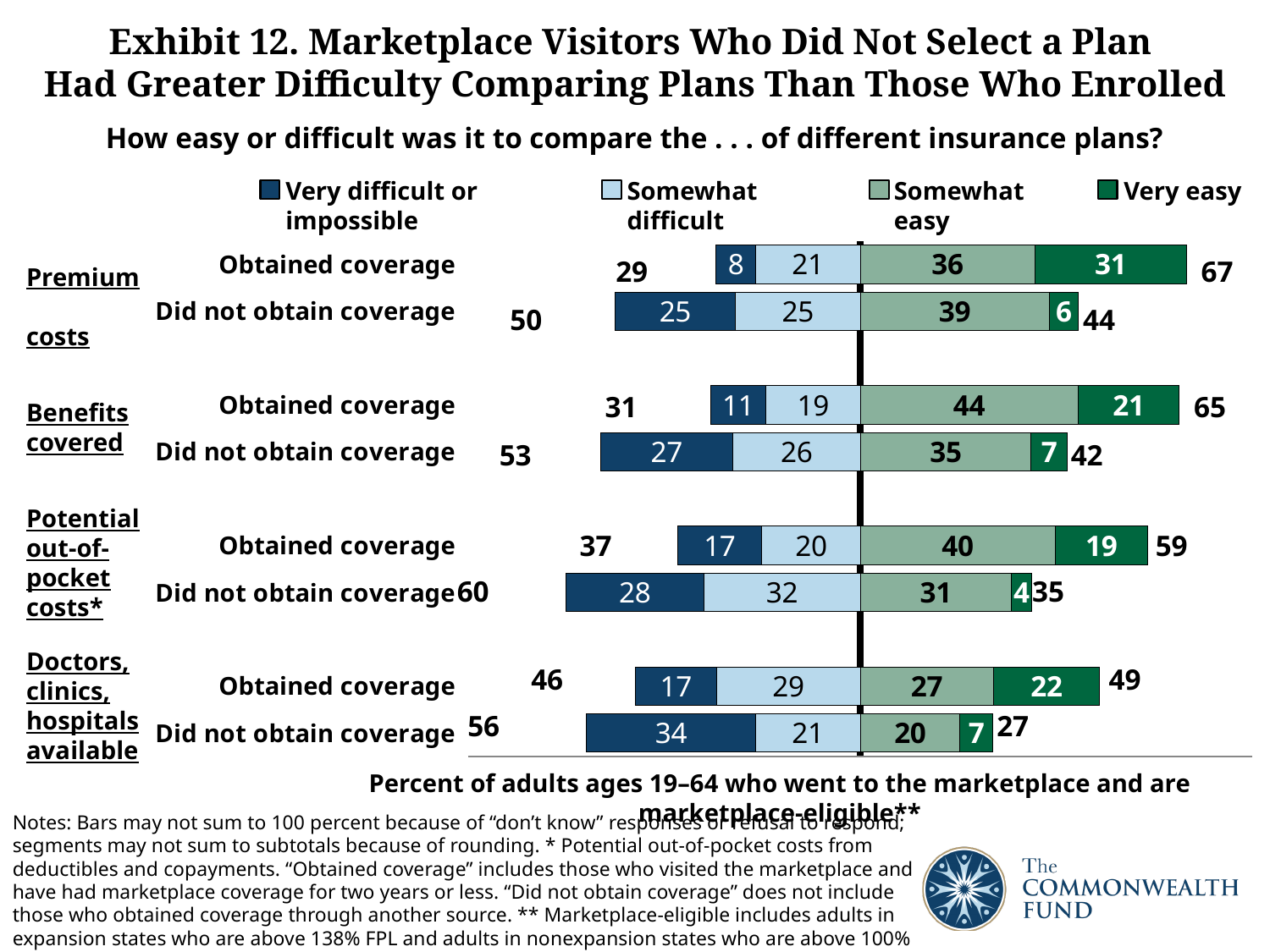
For benefits covered, what is the difference in the 'Somewhat easy' value between those who obtained coverage and those who did not? 9 How many plan features (row groups) are compared in the chart? 4 What percentage of those who obtained coverage said comparing premium costs was very easy? 31 How many response categories does the legend list? 4 Which bar has the lowest 'Very easy' value? Potential out-of-pocket costs, Did not obtain coverage Which response category is shown in the darkest blue in the legend? Very difficult or impossible Which bar has the highest 'Very easy' value? Premium costs, Obtained coverage What is the 'Somewhat easy' value for doctors, clinics, hospitals available among those who did not obtain coverage? 20 What is the combined 'difficult' subtotal shown for benefits covered among those who did not obtain coverage? 53 What kind of chart is shown on the slide? Stacked bar chart What is the 'Very difficult or impossible' value for doctors, clinics, hospitals available among those who did not obtain coverage? 34 For potential out-of-pocket costs, which group has the larger 'Somewhat difficult' value: obtained coverage or did not obtain coverage? Did not obtain coverage